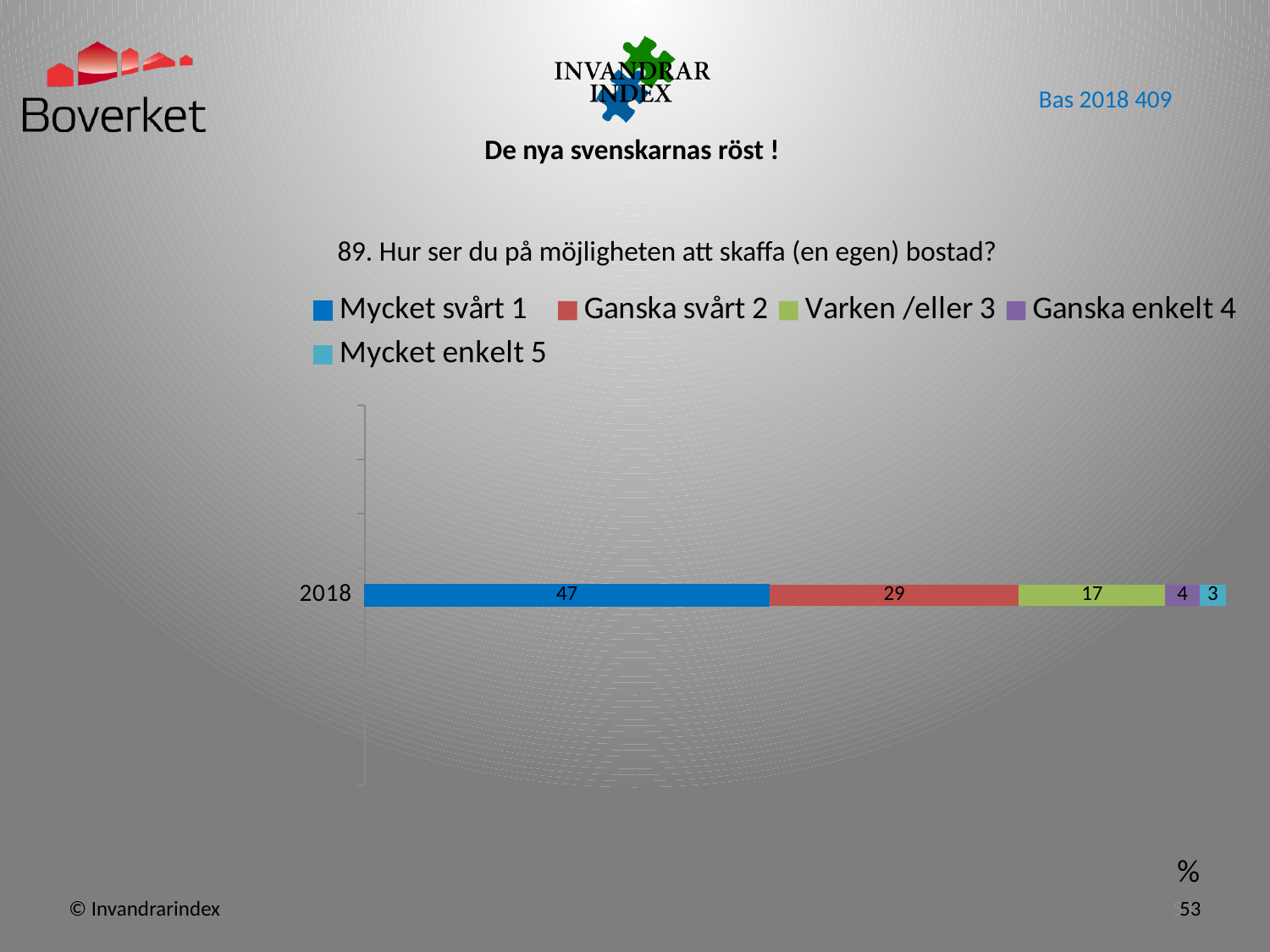
What is the value for 'Mycket enkelt 5' in the 2018 bar? 3 How many series does the legend list? 5 What is the value for 'Varken /eller 3' in the 2018 bar? 17 Which series has the highest value in the 2018 bar? Mycket svårt 1 Which is larger, the value for 'Varken /eller 3' or the value for 'Ganska enkelt 4'? Varken /eller 3 What is the value for 'Mycket svårt 1' in the 2018 bar? 47 What is the difference between the values for 'Mycket svårt 1' and 'Ganska svårt 2'? 18 What is the value for 'Ganska enkelt 4' in the 2018 bar? 4 What is the total of the stacked bar for 2018? 100 What kind of chart is shown on the slide? Stacked bar chart Which series has the lowest value in the 2018 bar? Mycket enkelt 5 What is the value for 'Ganska svårt 2' in the 2018 bar? 29